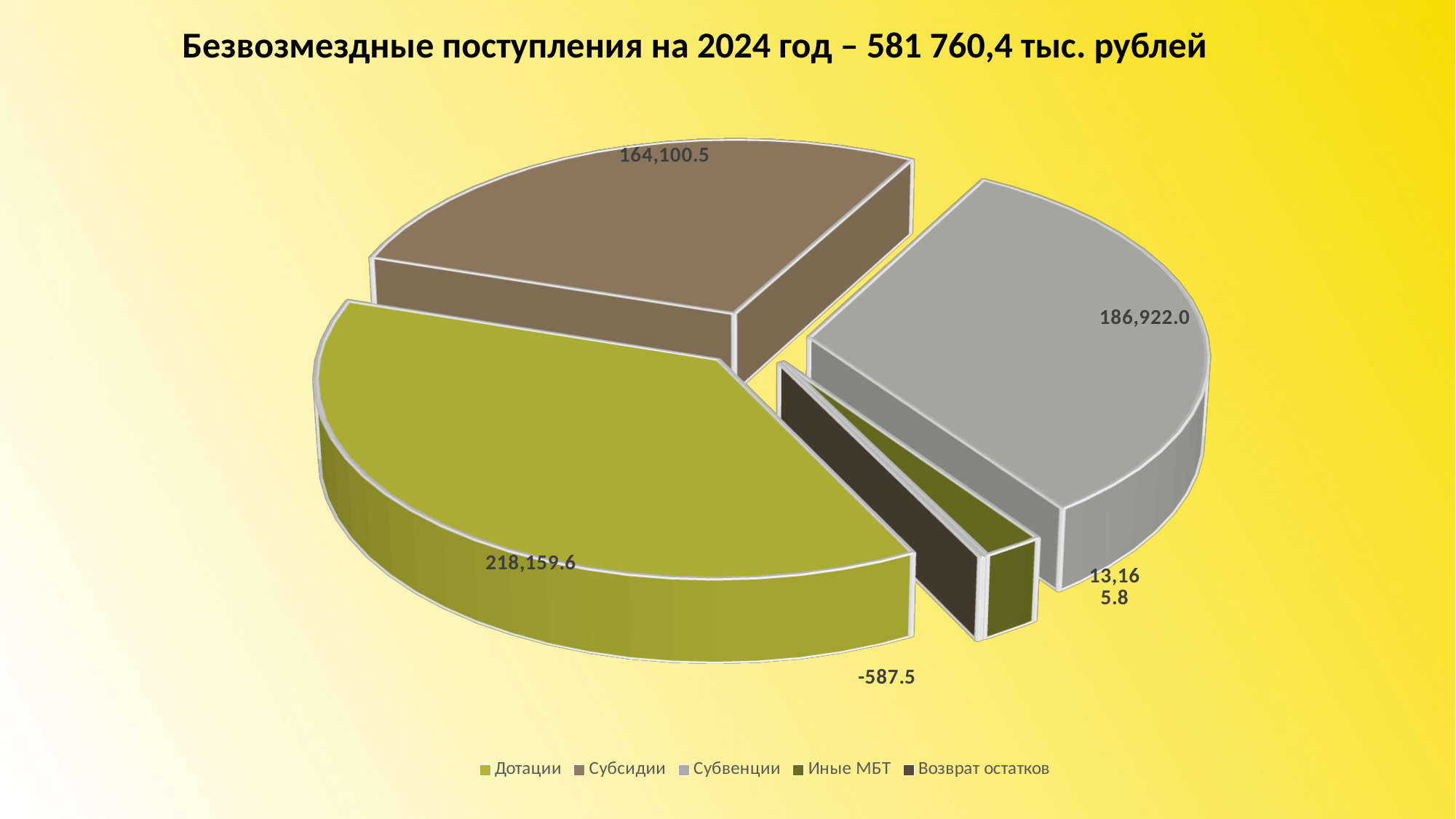
What is the value shown for Возврат остатков? -587.5 Which category has the largest value in the pie chart? Дотации Which is larger, the value for Субсидии or the value for Субвенции? Субвенции What is the value shown for Субвенции? 186,922.0 What is the value shown for Субсидии? 164,100.5 What is the difference between the values for Дотации and Субвенции? 31,237.6 What is the difference between the values for Субвенции and Субсидии? 22,821.5 How many categories does the legend of the pie chart list? 5 What is the value shown for Дотации? 218,159.6 What kind of chart is shown on the slide? pie chart What total amount is stated in the chart title for 2024? 581 760,4 тыс. рублей Which category has the smallest value in the pie chart? Возврат остатков